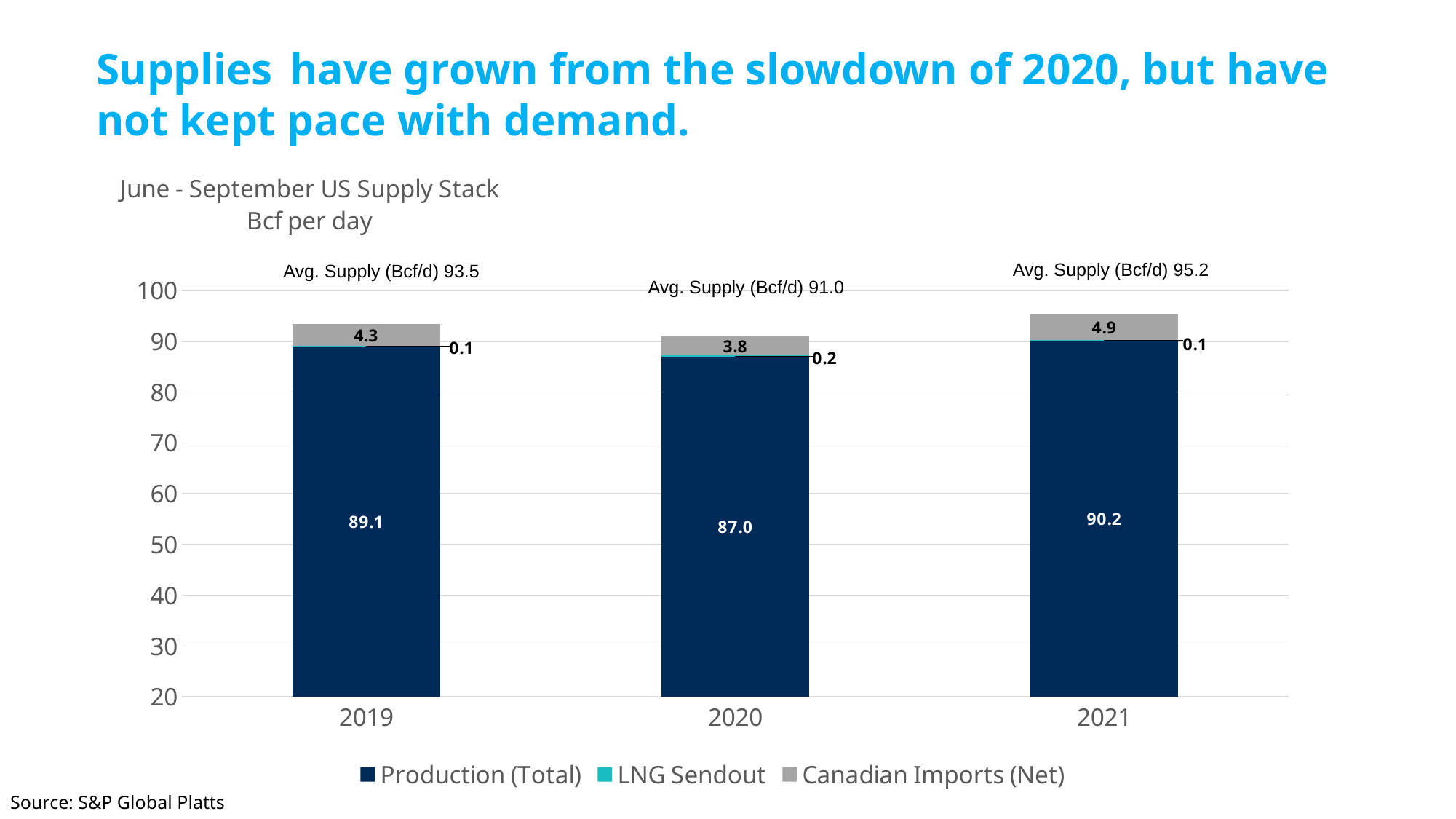
Is Canadian Imports (Net) larger in 2019 or 2020? 2019 Which year has the lowest Avg. Supply (Bcf/d)? 2020 What is the source cited for the chart? S&P Global Platts How many years are shown on the x axis? 3 What is the Avg. Supply (Bcf/d) shown for 2019? 93.5 What is the LNG Sendout value for 2020? 0.2 What is the difference in Production (Total) between 2021 and 2020? 3.2 What kind of chart is shown on the slide? Stacked bar chart What is the Canadian Imports (Net) value for 2021? 4.9 Which year has the highest Production (Total)? 2021 How many series does the legend list? 3 What is the Production (Total) value for 2020? 87.0